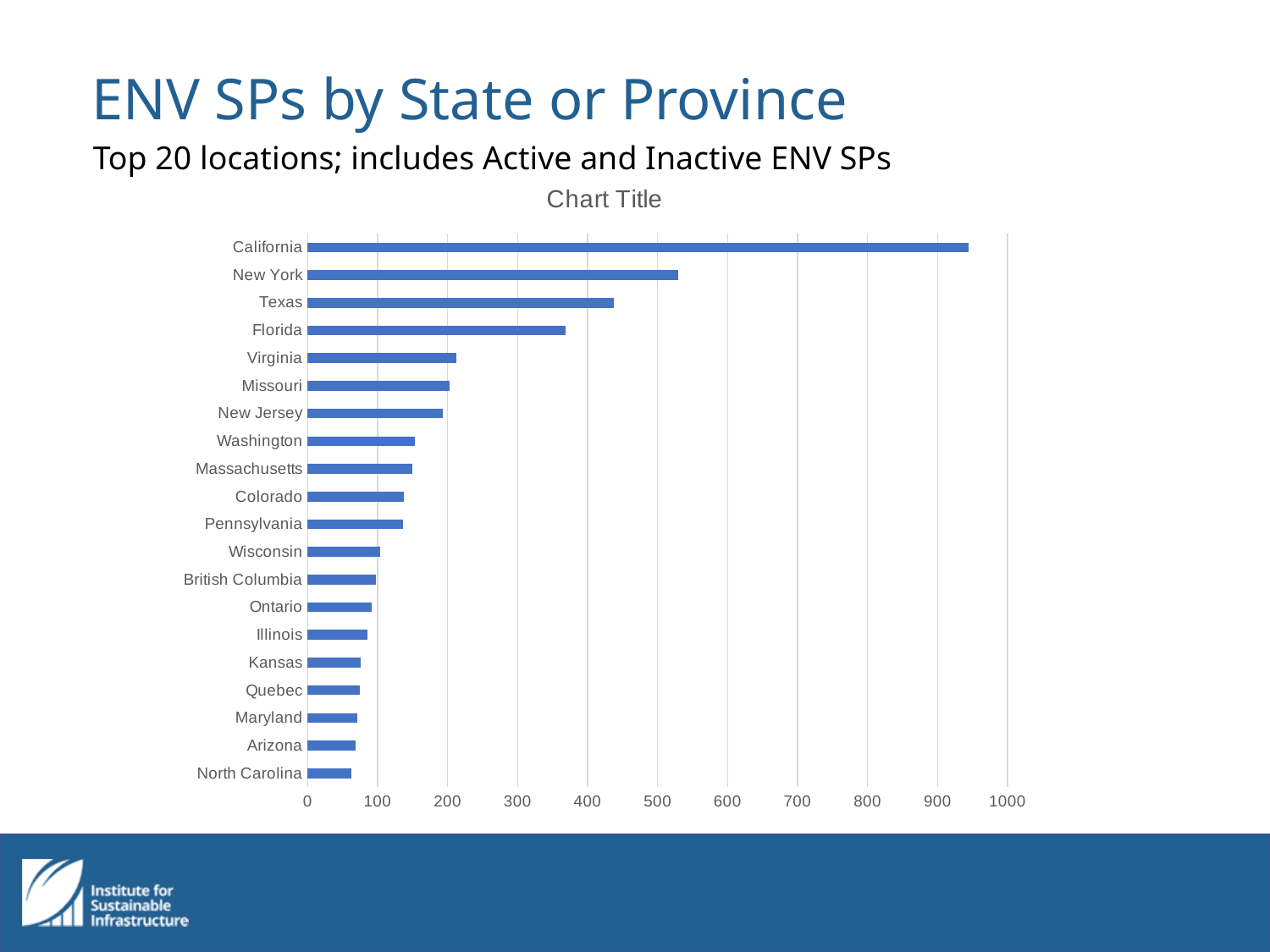
Is the value for North Carolina greater or less than 100? less Is the value for Florida greater or less than 400? less Is the value for New York greater or less than 500? greater Which has more ENV SPs, New York or Texas? New York Do the bar values increase or decrease going from the top of the chart to the bottom? decrease Which state or province has the lowest number of ENV SPs among those shown? North Carolina Which state or province has the highest number of ENV SPs? California What is the title printed above the chart area? Chart Title How many states or provinces are shown in the chart? 20 What kind of chart is shown on the slide? bar chart